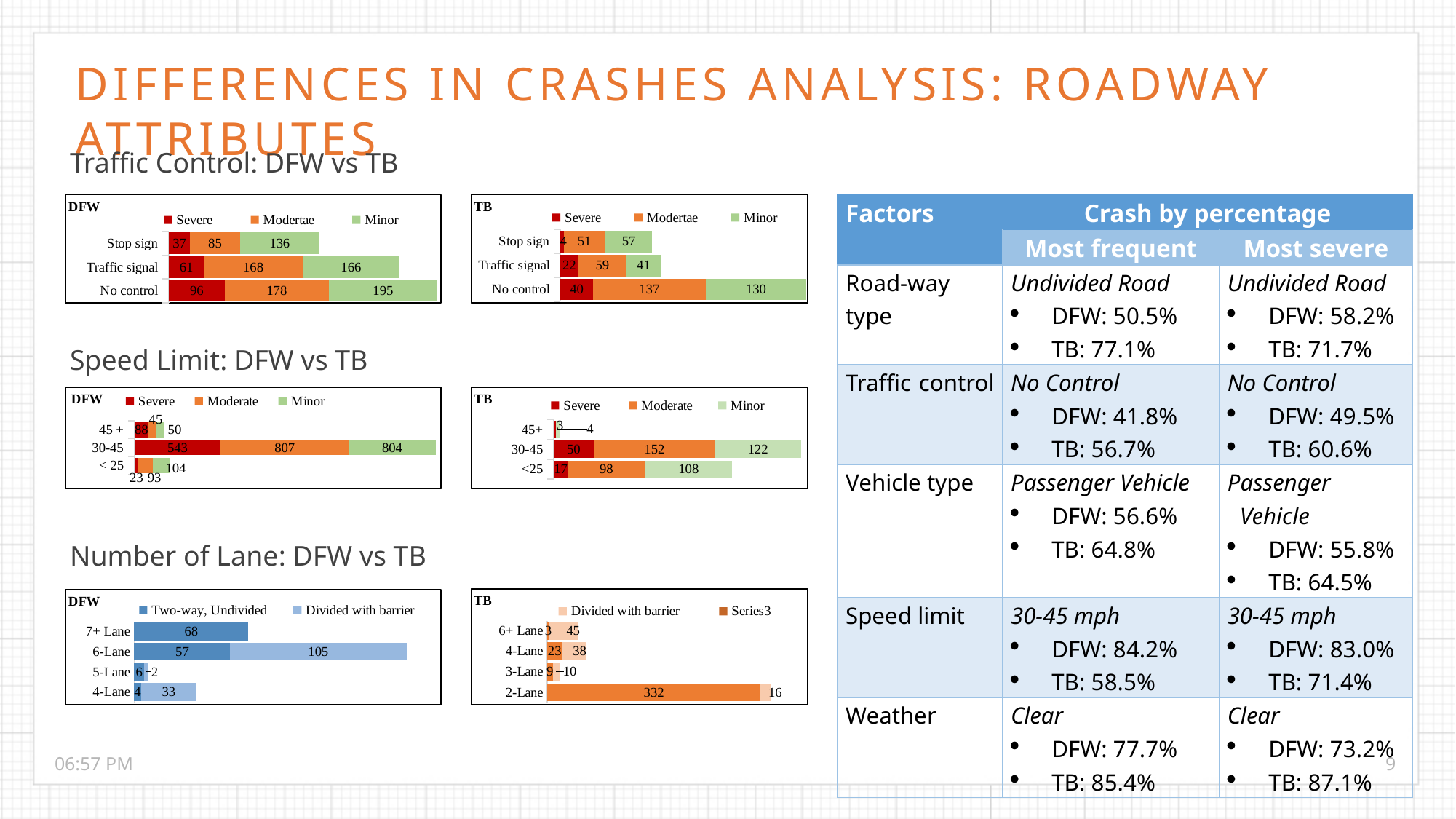
In the Speed Limit DFW chart, what is the Moderate value for 30-45? 807 In the Speed Limit TB chart, which category has the highest Severe value? 30-45 In the Traffic Control DFW chart, what is the Minor value for No control? 195 In the Traffic Control TB chart, which category has the lowest Severe value? Stop sign In the Number of Lane DFW chart, what is the Divided with barrier value for 6-Lane? 105 In the Number of Lane TB chart, which category has the highest Divided with barrier value? 6+ Lane In the Number of Lane DFW chart, how many series does the legend list? 2 What kind of chart is the Traffic Control DFW chart? Stacked bar chart In the Traffic Control TB chart, what is the Modertae value for No control? 137 In the Speed Limit TB chart, what is the difference between the Moderate and Minor values for 30-45? 30 In the Traffic Control DFW chart, what is the total of the stacked bar for Traffic signal? 395 In the Number of Lane TB chart, how many lane categories are shown? 4